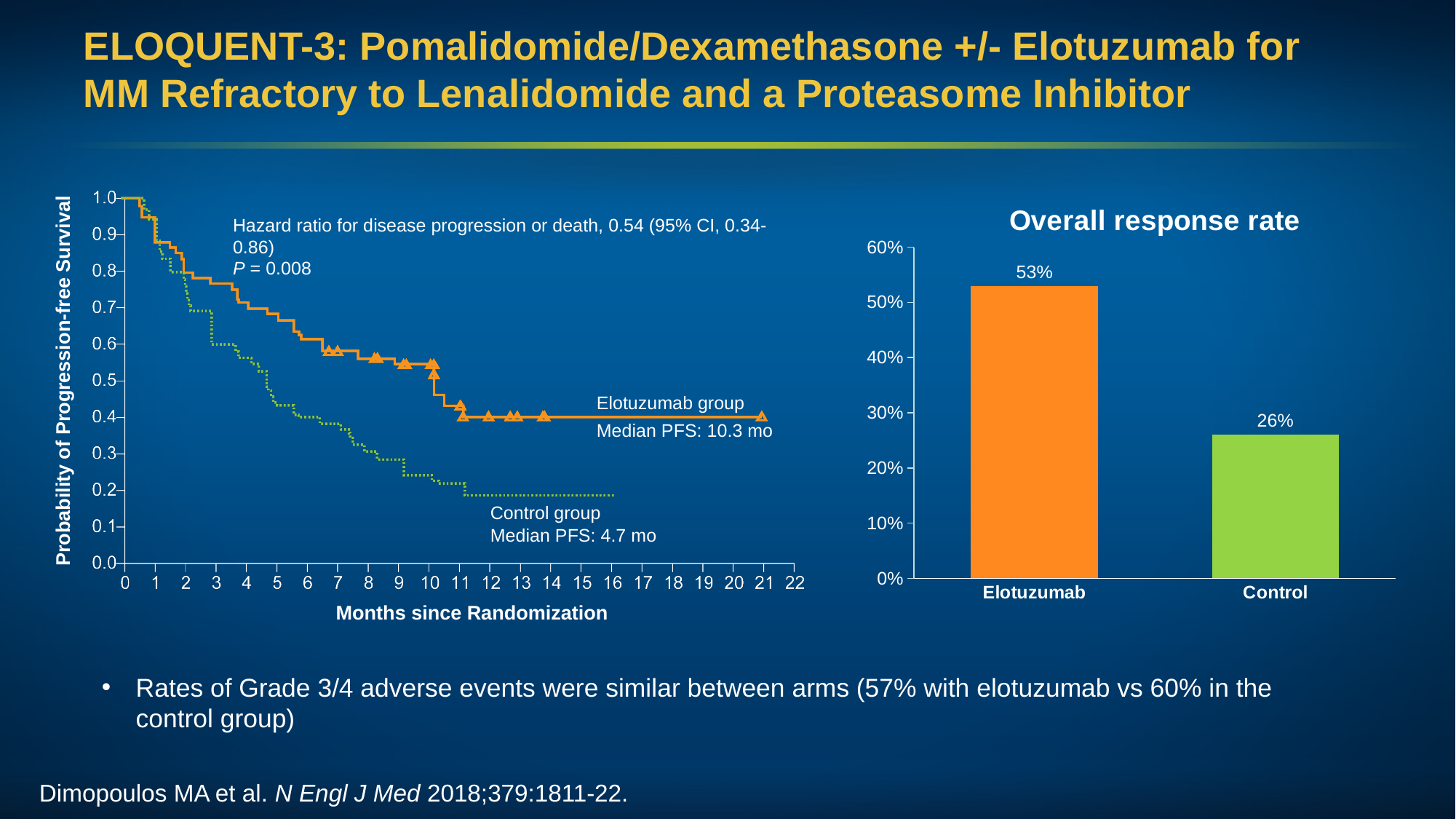
In the Overall response rate chart, what colour is the Elotuzumab bar? Orange In the Overall response rate chart, how many categories are shown on the x axis? 2 In the Overall response rate chart, what is the overall response rate for the Elotuzumab group? 53% In the progression-free survival chart on the left, what is the median PFS for the Control group? 4.7 mo In the Overall response rate chart, what is the overall response rate for the Control group? 26% What kind of chart is the Overall response rate chart? Bar chart In the Overall response rate chart, what is the difference in overall response rate between the Elotuzumab and Control groups? 27% In the Overall response rate chart, which group has the higher overall response rate? Elotuzumab In the Overall response rate chart, is the value for Control greater or less than 30%? less In the progression-free survival chart on the left, do the survival curves rise or fall as months since randomization increase? Fall In the progression-free survival chart on the left, what is the median PFS for the Elotuzumab group? 10.3 mo In the progression-free survival chart on the left, what is the hazard ratio for disease progression or death? 0.54